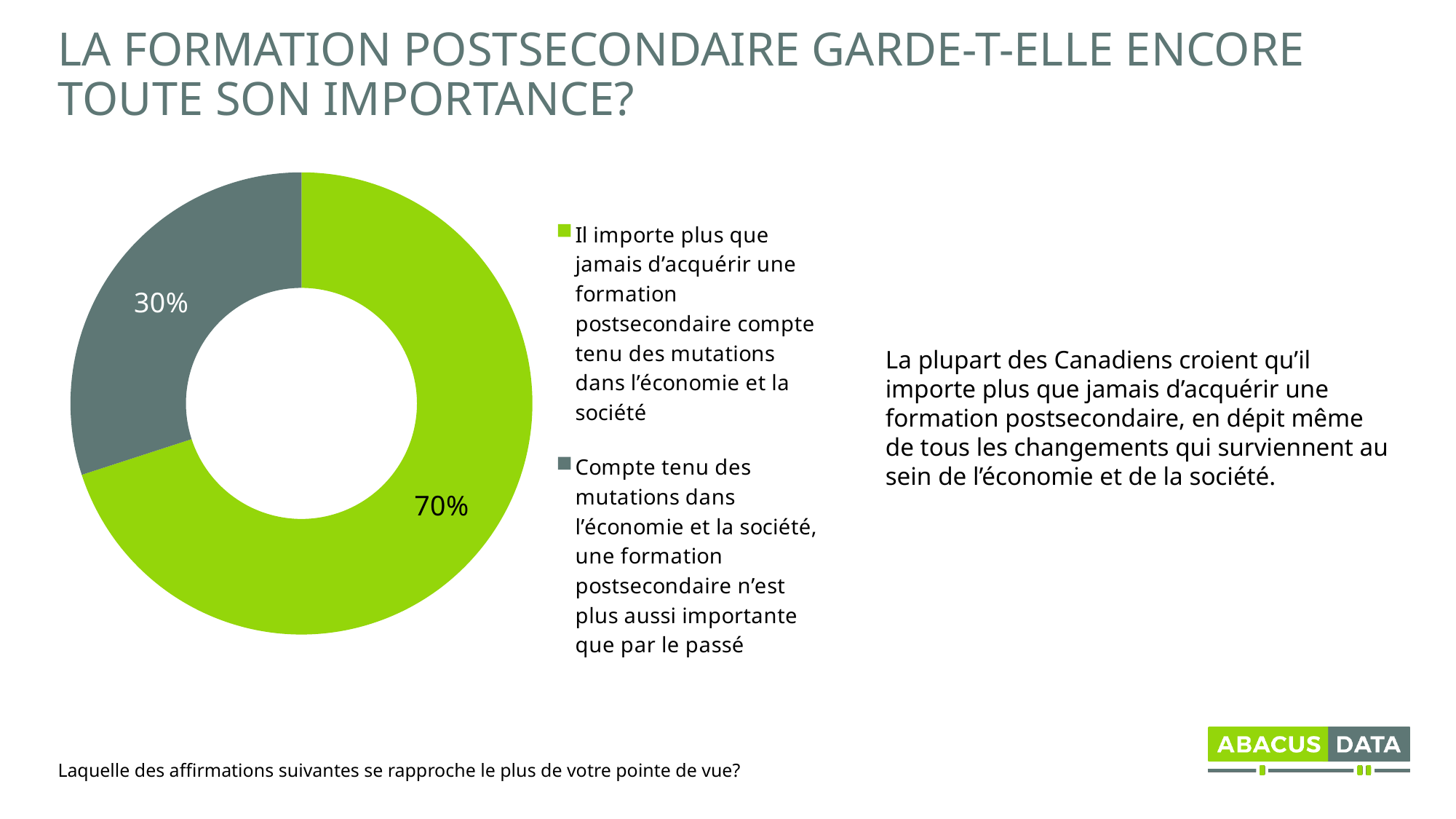
What share of respondents chose "Compte tenu des mutations dans l'économie et la société, une formation postsecondaire n'est plus aussi importante que par le passé"? 30% Which response option has the largest share of the chart? Il importe plus que jamais d'acquérir une formation postsecondaire compte tenu des mutations dans l'économie et la société How many entries does the legend list? 2 What colour is the slice labelled 70%? Green How many slices does the chart have? 2 What share of respondents chose "Il importe plus que jamais d'acquérir une formation postsecondaire compte tenu des mutations dans l'économie et la société"? 70% What is the total of the two slices shown on the chart? 100% What kind of chart is shown on the slide? Doughnut (pie) chart What colour is the slice labelled 30%? Grey What is the difference in percentage points between the two slices of the chart? 40 percentage points Which is larger: the share saying postsecondary education matters more than ever, or the share saying it is no longer as important as in the past? The share saying it matters more than ever Which response option has the smallest share of the chart? Compte tenu des mutations dans l'économie et la société, une formation postsecondaire n'est plus aussi importante que par le passé